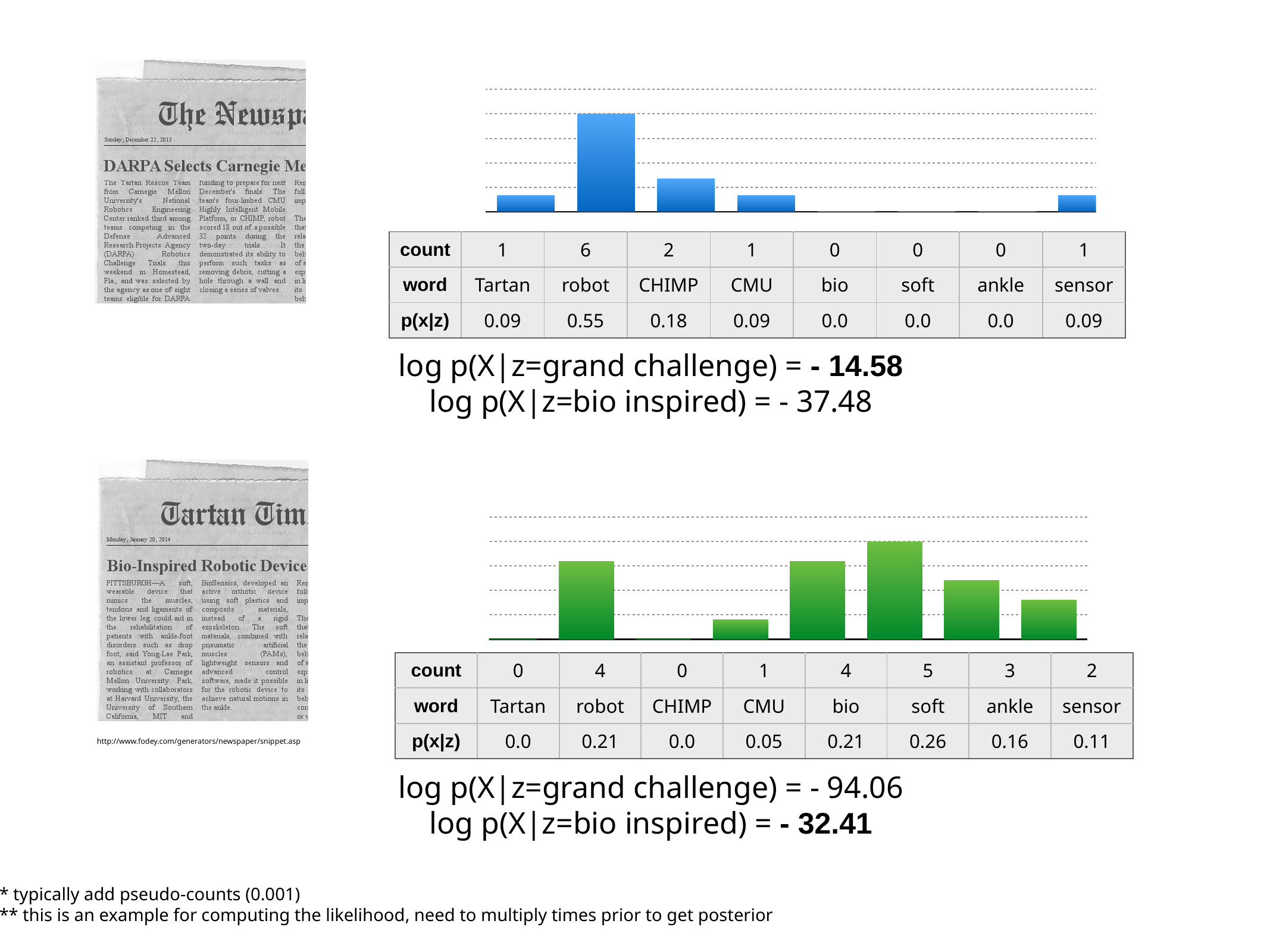
In the bottom chart, which is larger, the bar for bio or the bar for CMU? bio In the table under the top chart, what is p(x|z) for robot? 0.55 In the top chart, which is larger, the bar for CHIMP or the bar for CMU? CHIMP In the table under the bottom chart, what is the count for ankle? 3 In the top chart, which word has the highest bar? robot In the bottom chart, which word has the highest bar? soft Using the table under the bottom chart, what is the difference between the count for soft and the count for robot? 1 What colour are the bars in the bottom chart? green In the table under the bottom chart, what is p(x|z) for soft? 0.26 In the table under the top chart, what is the count for CHIMP? 2 How many word categories does the top chart show? 8 What kind of chart is the top chart on the slide? bar chart